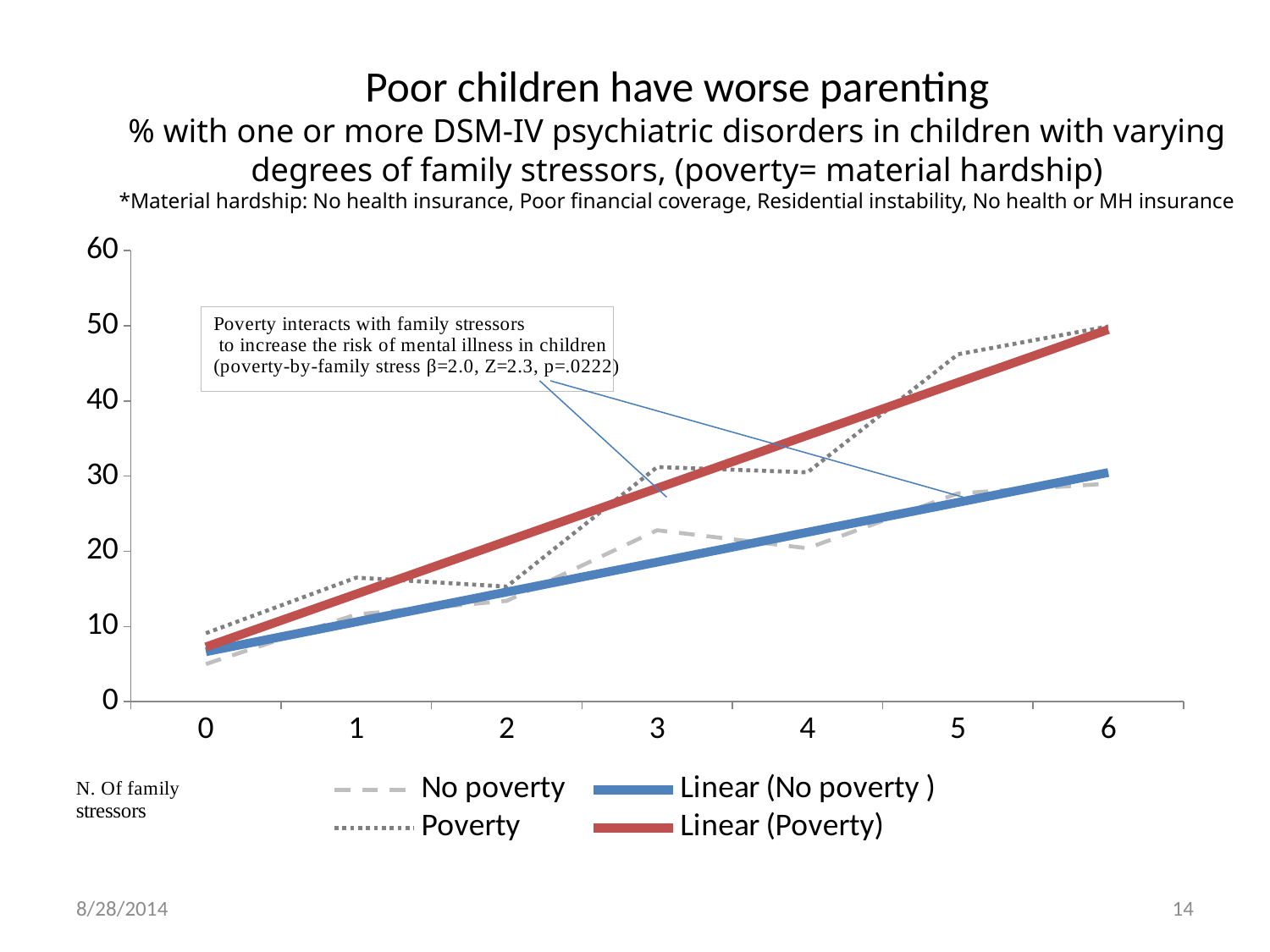
What colour is the Linear (Poverty) trend line? red At which number of family stressors is the Poverty series at its highest? 6 Is the value for the No poverty series at 3 family stressors greater or less than 20? greater Is the value for the Poverty series at 5 family stressors greater or less than 40? greater At which number of family stressors is the No poverty series at its lowest? 0 Do the values for the Poverty series generally rise or fall as the number of family stressors increases? rise Is the value for the No poverty series at 0 family stressors greater or less than 10? less How many entries does the chart legend list? 4 What kind of chart is shown on the slide? line chart How many points along the x axis (number of family stressors) are plotted for each series? 7 At 5 family stressors, which series has the larger value, Poverty or No poverty? Poverty